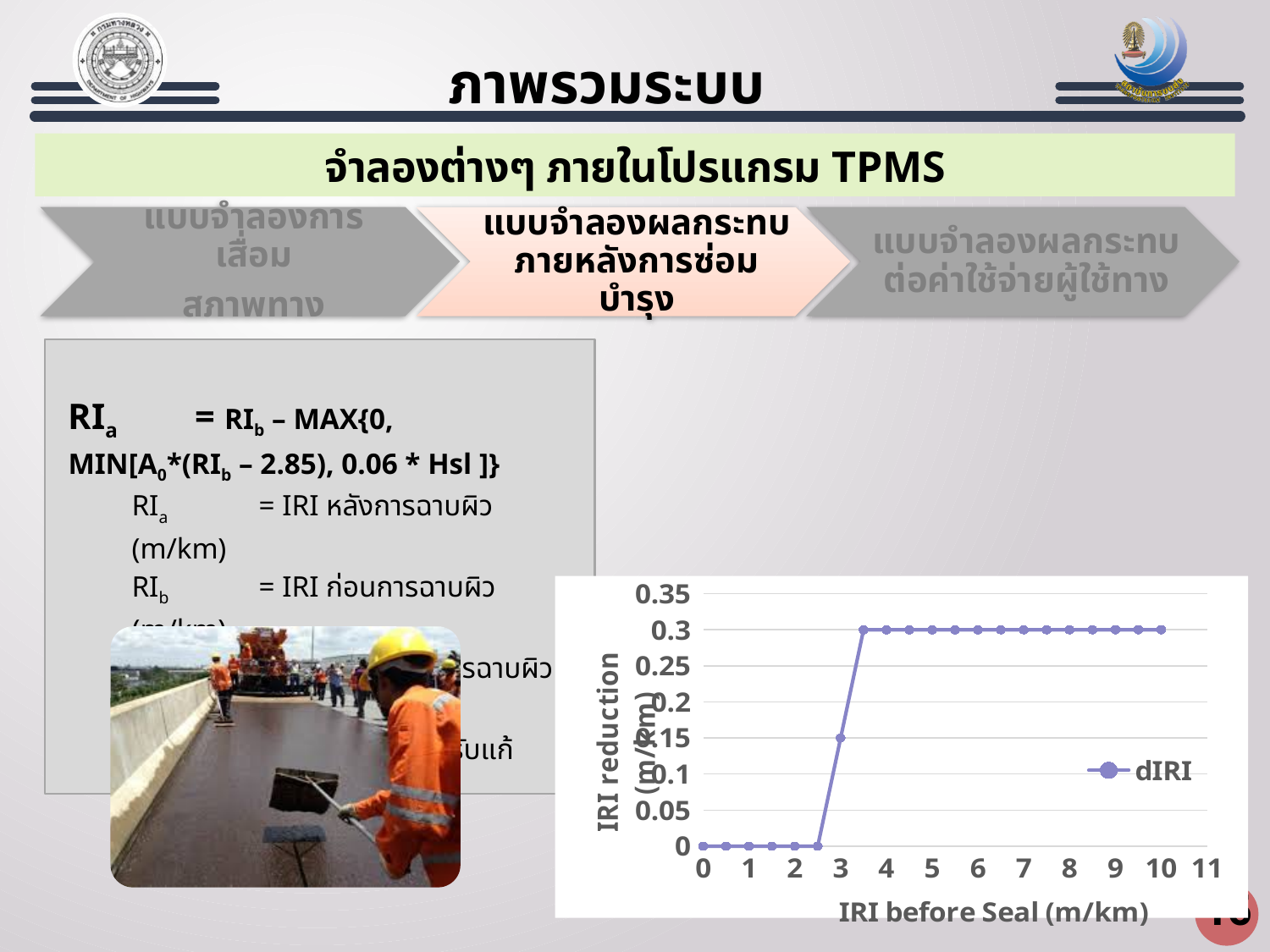
What is the title of the chart's x axis? IRI before Seal (m/km) Is the dIRI value at IRI before Seal of 8 m/km greater or less than 0.25? greater Do the dIRI values rise or fall as IRI before Seal increases along the x axis? rise Which has the larger dIRI value: IRI before Seal of 2 m/km or 4 m/km? 4 m/km What kind of chart is shown on the slide? line chart What is the dIRI value when IRI before Seal is 5 m/km? 0.3 What is the difference between the dIRI value at IRI before Seal of 4 m/km and at 3 m/km? 0.15 How many series does the chart's legend list? 1 What is the dIRI value when IRI before Seal is 1 m/km? 0 What is the name of the series shown in the chart's legend? dIRI What is the dIRI value when IRI before Seal is 3 m/km? 0.15 What is the highest dIRI value reached in the chart? 0.3